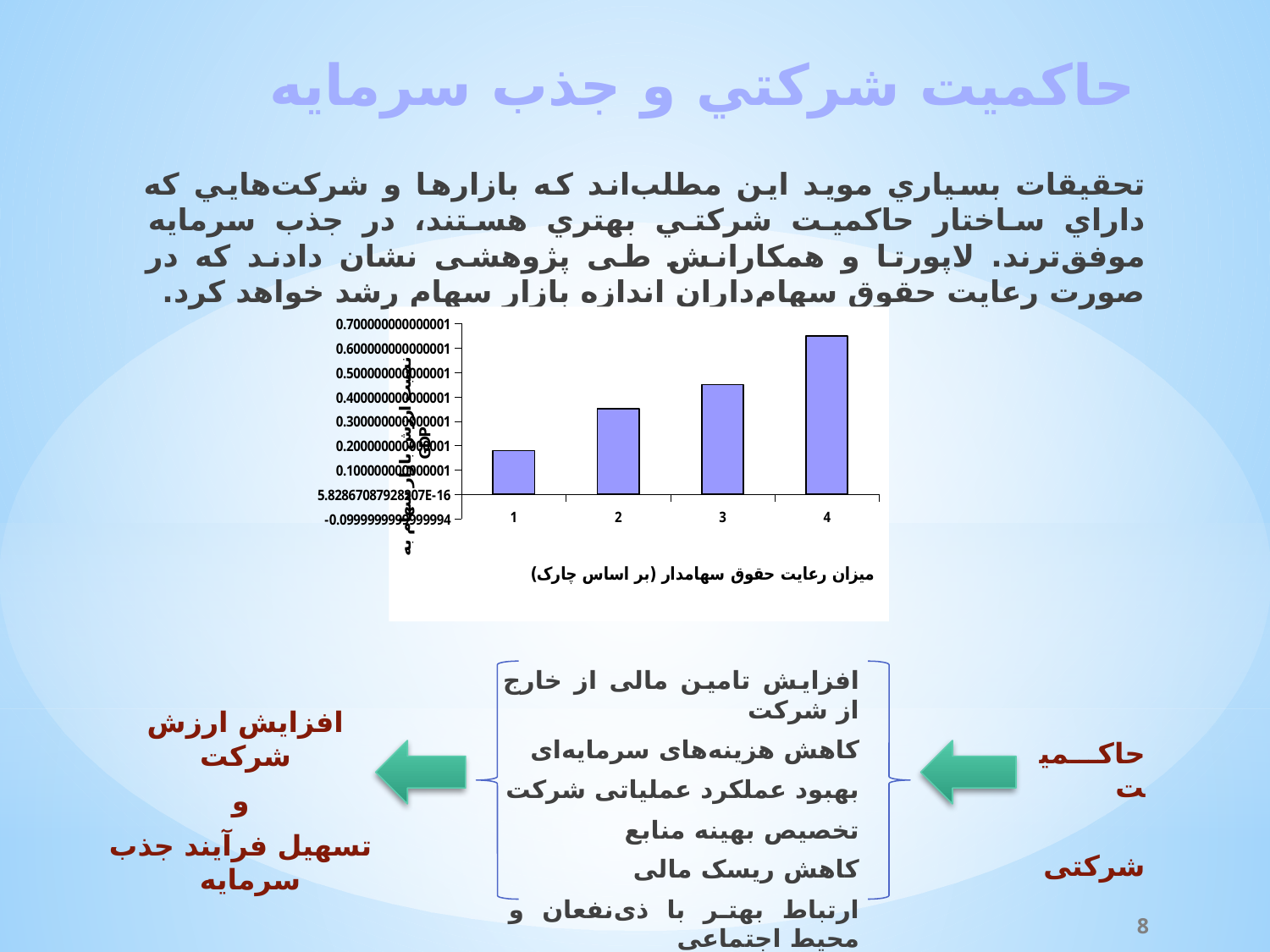
Which category has the highest bar in the chart? 4 What kind of chart is shown on the slide? bar chart Is the value for category 4 greater or less than 0.6? greater Is the value for category 3 greater or less than 0.4? greater What is the title of the x axis of the chart? میزان رعایت حقوق سهامدار (بر اساس چارک) Which category has the larger value, 1 or 3? 3 How many categories are shown on the x axis of the chart? 4 Which category has the larger value, 2 or 4? 4 Is the value for category 2 greater or less than 0.4? less Which category has the lowest bar in the chart? 1 Do the bar values rise or fall from category 1 to category 4? rise